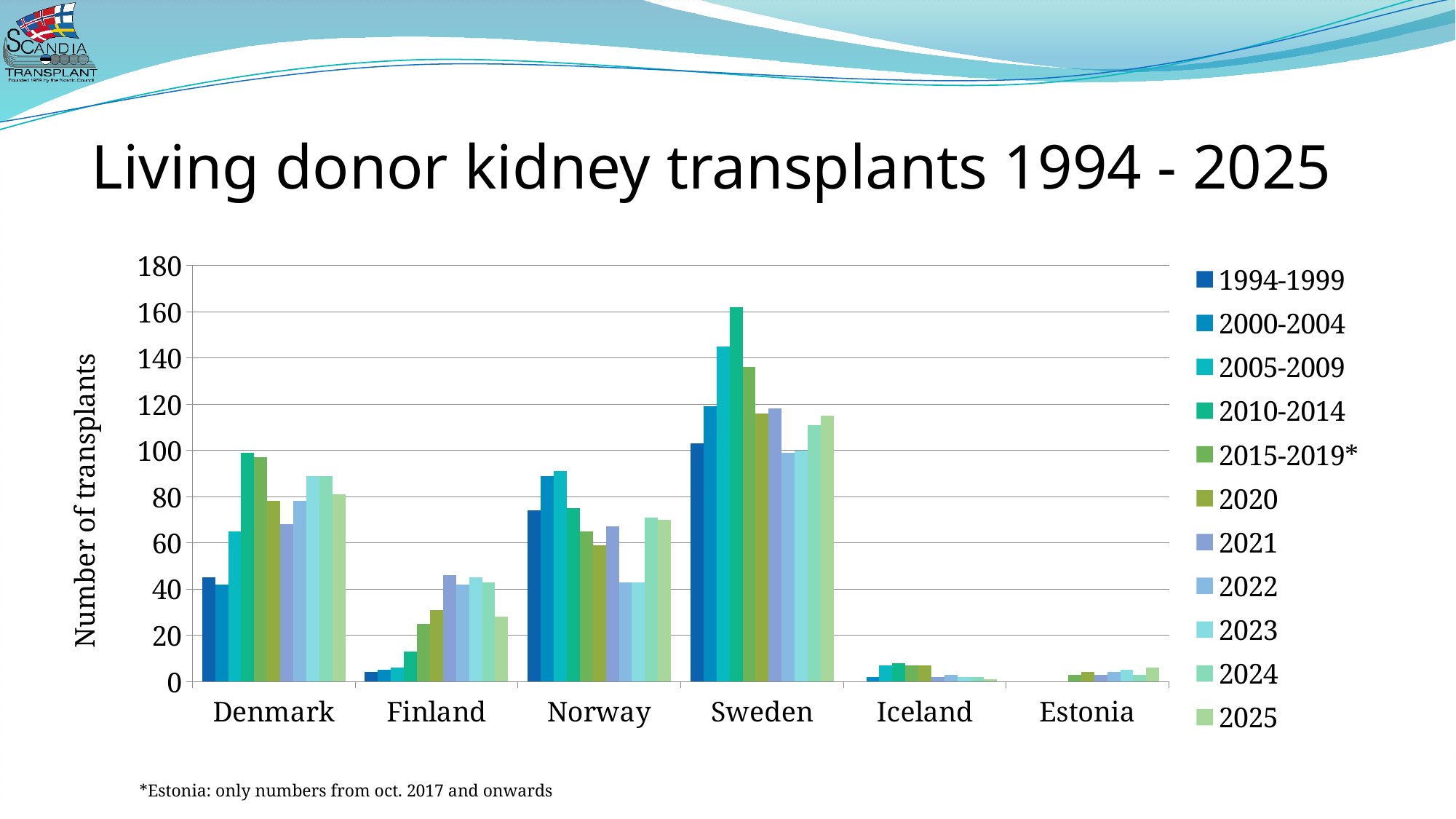
Is the value for Iceland in 2010-2014 greater or less than 20? less For Finland, do the values generally rise or fall from 1994-1999 through 2021? rise Which country has the tallest bar in the chart? Sweden Is the value for Sweden in 2010-2014 greater or less than 140? greater What kind of chart is shown on the slide? bar chart Which is larger, the 2023 value for Denmark or the 2023 value for Norway? Denmark How many countries are shown on the x axis of the chart? 6 What is the title of the chart? Living donor kidney transplants 1994 - 2025 Is the value for Finland in 2021 greater or less than 40? greater What is the label on the y axis of the chart? Number of transplants For Sweden, which period has the highest number of transplants? 2010-2014 How many series does the legend list? 11